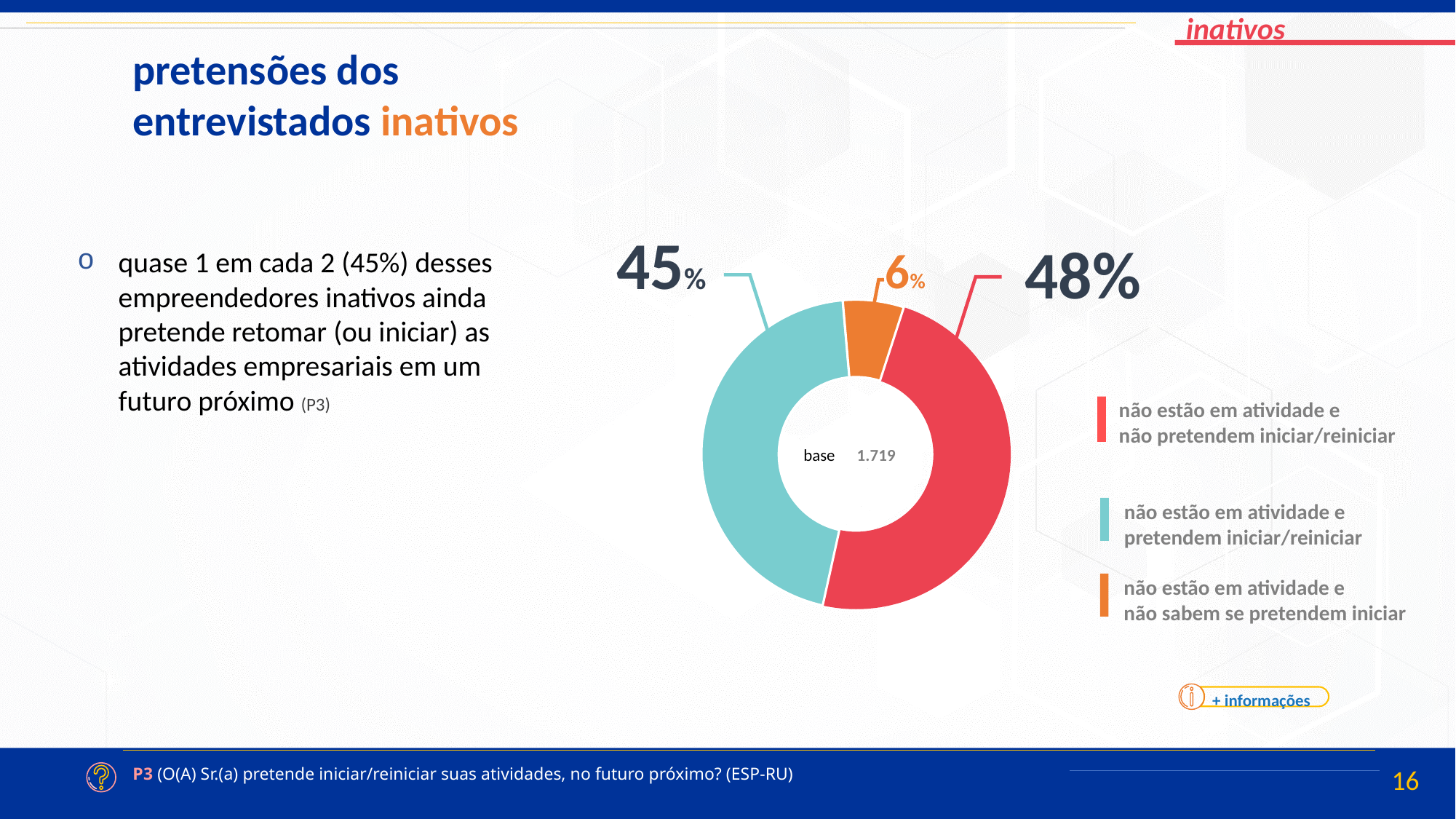
What is the difference in percentage points between the 45% slice and the 6% slice? 39 percentage points What is the difference in percentage points between the share that does not intend to start/restart (48%) and the share that intends to start/restart (45%)? 3 percentage points What kind of chart is shown on the slide? Pie chart (donut) Which category has the largest share of the pie? não estão em atividade e não pretendem iniciar/reiniciar What percentage of inactive respondents do not know whether they intend to start ("não sabem se pretendem iniciar")? 6% Which category has the smallest share of the pie? não estão em atividade e não sabem se pretendem iniciar Which colour represents the category "não estão em atividade e não sabem se pretendem iniciar"? Orange What percentage of inactive respondents intend to start/restart their activities ("não estão em atividade e pretendem iniciar/reiniciar")? 45% What percentage of inactive respondents do not intend to start/restart their activities ("não estão em atividade e não pretendem iniciar/reiniciar")? 48% What is the base (number of respondents) shown in the centre of the donut chart? 1.719 How many slices does the pie chart have? 3 Is the share of respondents who intend to start/restart their activities greater or less than 50%? less